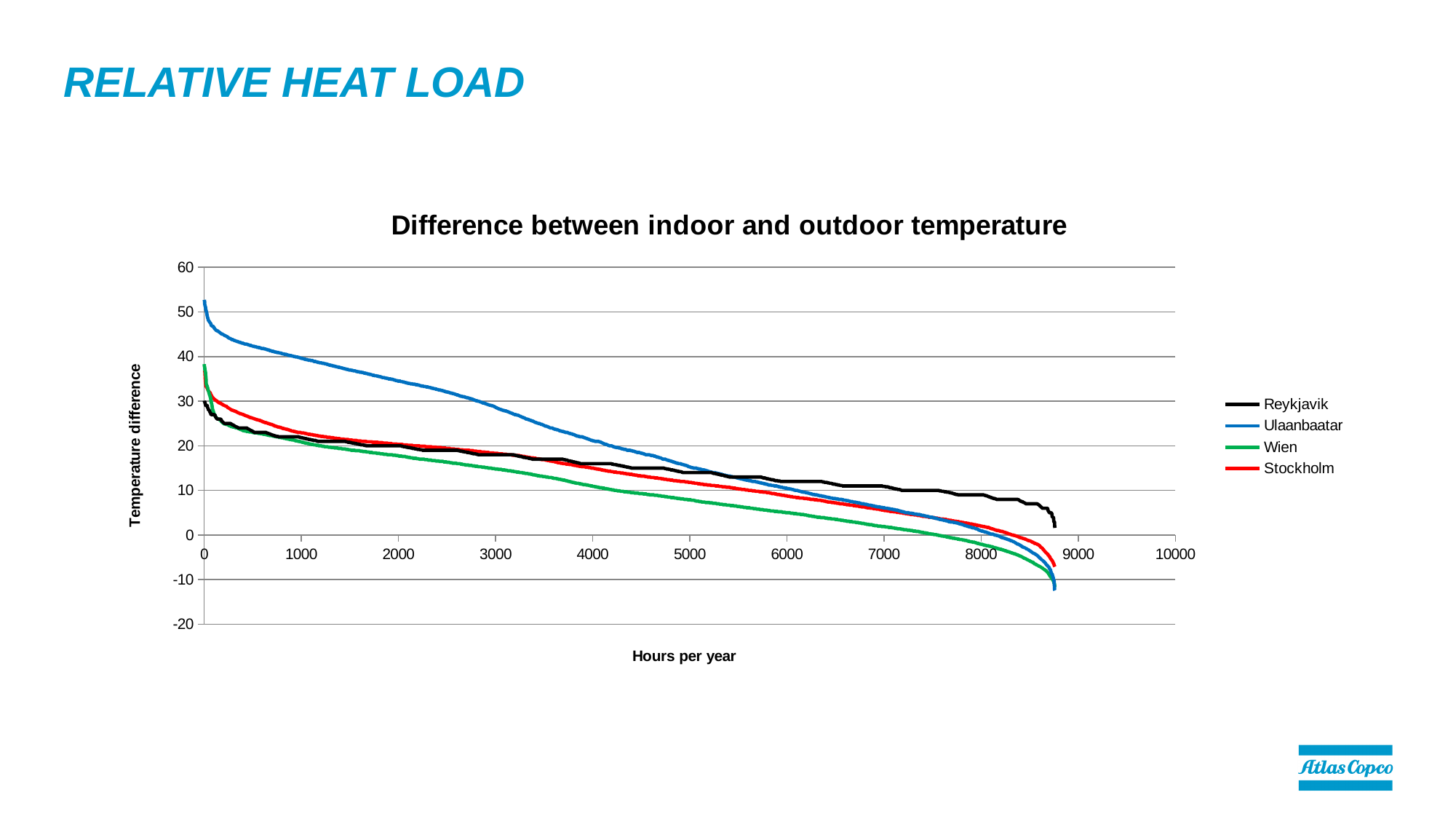
Is the value for Ulaanbaatar at 0 hours per year greater or less than 50? greater What is the label of the x axis? Hours per year At 2000 hours per year, which series has the larger temperature difference, Ulaanbaatar or Wien? Ulaanbaatar What is the title of the chart? Difference between indoor and outdoor temperature Which series has the highest temperature difference at 8000 hours per year? Reykjavik Is the value for Ulaanbaatar at 2000 hours per year greater or less than 30? greater What kind of chart is shown on the slide? Line chart Which series has the highest temperature difference at 0 hours per year? Ulaanbaatar How many series does the legend list? 4 Which series reaches the lowest temperature difference at the right end of the chart? Ulaanbaatar Is the value for Wien at 6000 hours per year greater or less than 10? less Do the values for Ulaanbaatar rise or fall as hours per year increase? Fall